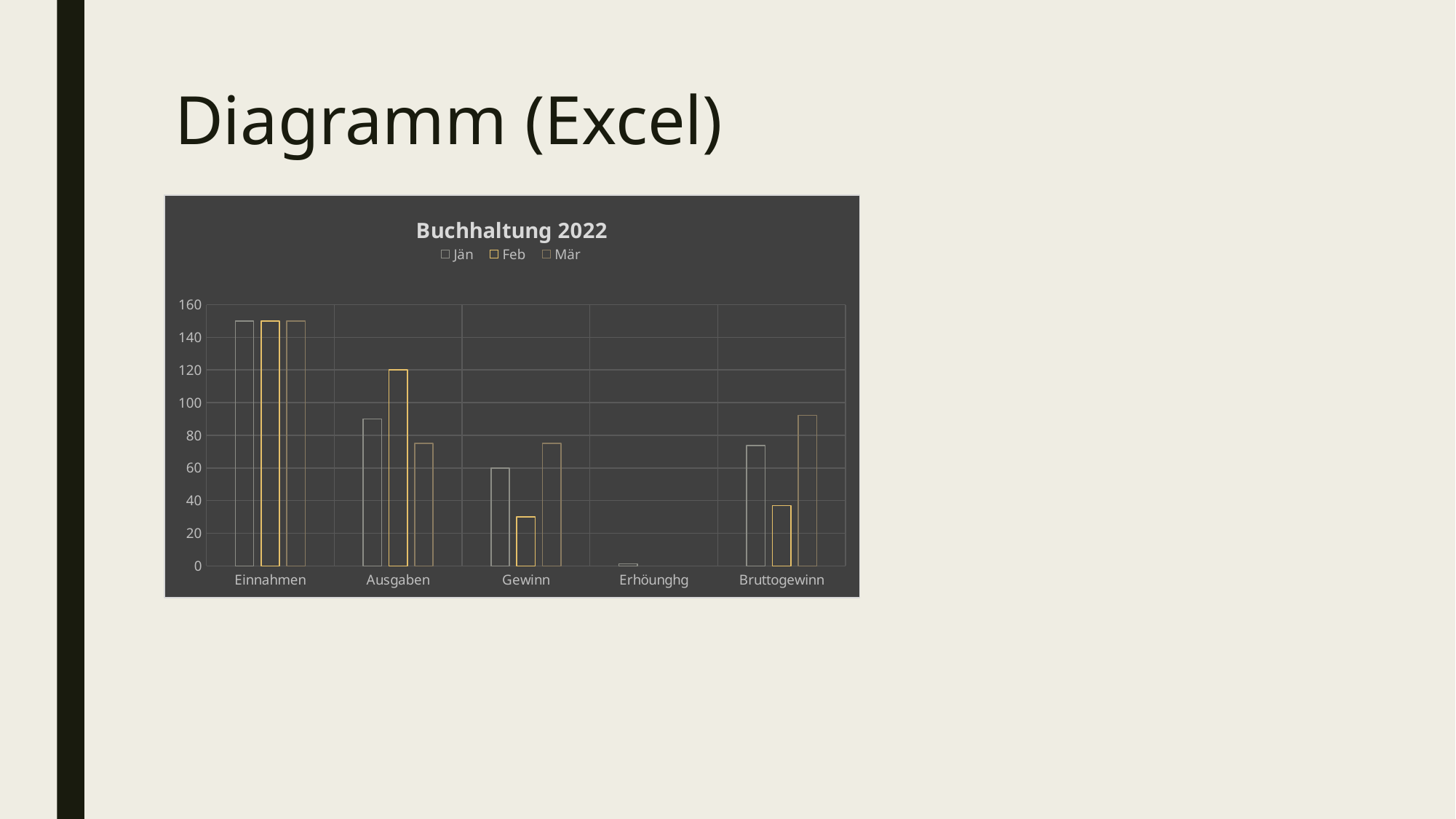
How many categories are shown on the x axis? 5 Is the Jän value for Einnahmen greater or less than 140? greater What is the title of the chart? Buchhaltung 2022 How many series does the legend list? 3 Which category has the highest Feb value? Einnahmen For Ausgaben, which is larger: the Feb value or the Mär value? Feb Is the Mär value for Bruttogewinn greater or less than 80? greater What kind of chart is shown on the slide? bar chart What is the Jän value for Gewinn? 60 What is the Feb value for Ausgaben? 120 Which category has the lowest Jän value? Erhöunghg Is the Feb value for Gewinn greater or less than 40? less